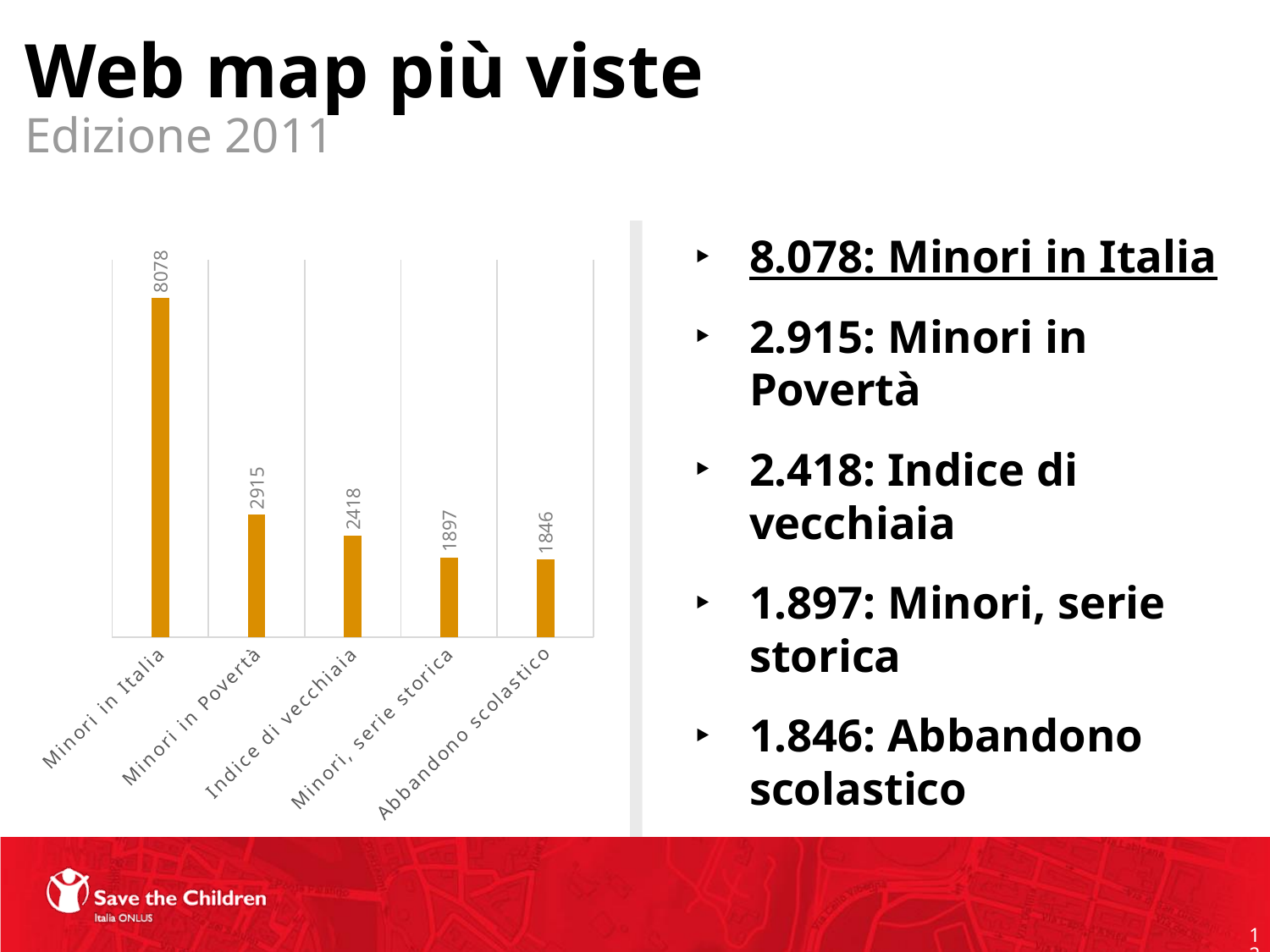
What is the difference between the values for Minori, serie storica and Abbandono scolastico? 51 Which is larger, the value for Minori in Povertà or the value for Indice di vecchiaia? Minori in Povertà How many categories are shown in the chart? 5 What is the value for Minori in Italia? 8078 What is the value for Indice di vecchiaia? 2418 Which category has the highest value? Minori in Italia What is the value for Abbandono scolastico? 1846 What is the value for Minori in Povertà? 2915 Do the values rise or fall from left to right along the x axis? fall What kind of chart is shown on the slide? bar chart Which category has the lowest value? Abbandono scolastico What is the difference between the values for Minori in Italia and Minori in Povertà? 5163